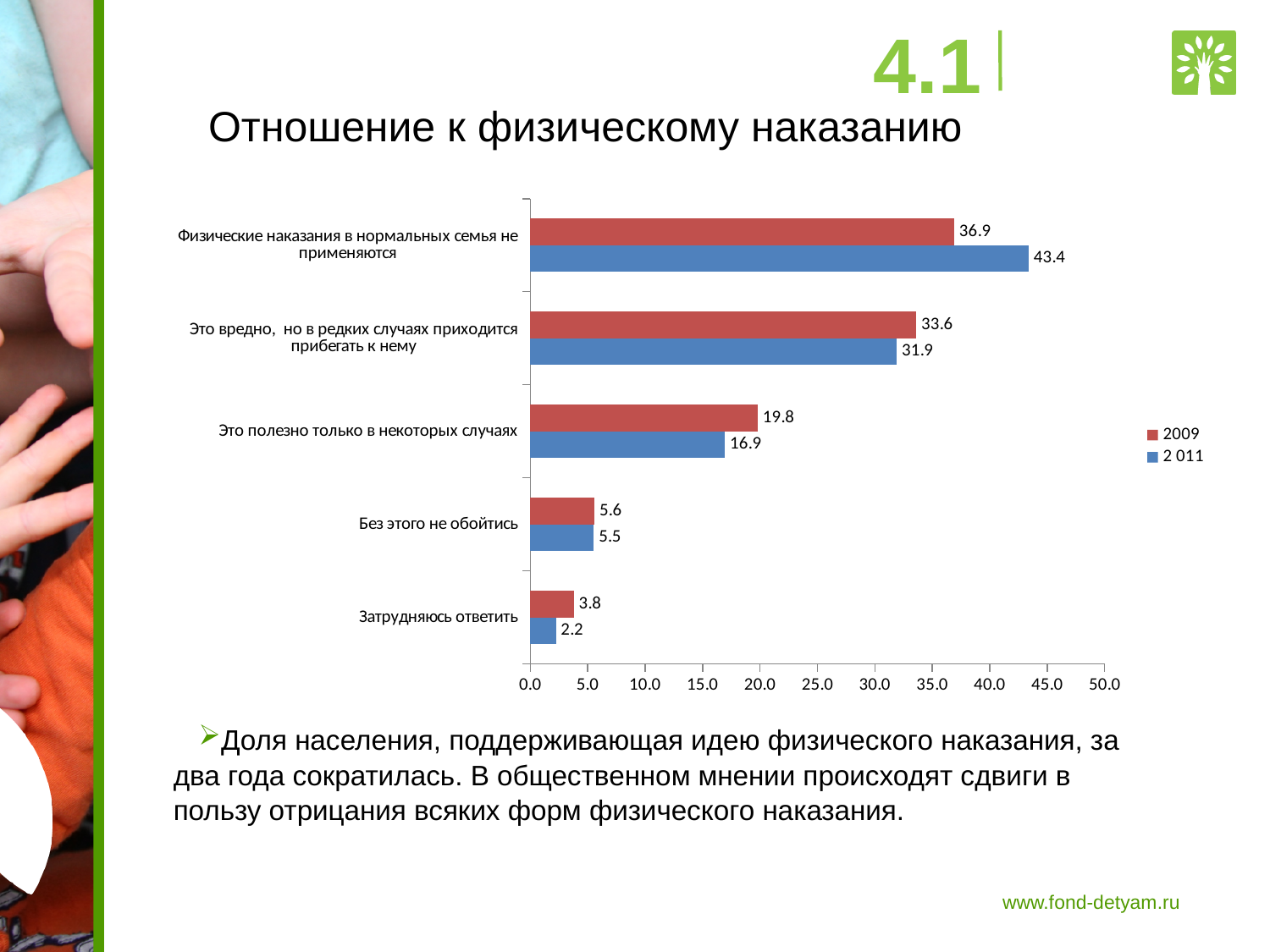
What type of chart is shown on the slide? Bar chart How many categories are shown on the chart? 5 What is the difference between the 2 011 and 2009 values for "Физические наказания в нормальных семья не применяются"? 6.5 What is the 2 011 value for "Это полезно только в некоторых случаях"? 16.9 How many series does the legend list? 2 What is the 2009 value for "Физические наказания в нормальных семья не применяются"? 36.9 Which category has the highest 2 011 value? Физические наказания в нормальных семья не применяются What is the title of the slide? Отношение к физическому наказанию What is the 2 011 value for "Физические наказания в нормальных семья не применяются"? 43.4 Which category has the lowest 2009 value? Затрудняюсь ответить For "Это вредно, но в редких случаях приходится прибегать к нему", which year has the larger value, 2009 or 2 011? 2009 What is the 2009 value for "Затрудняюсь ответить"? 3.8